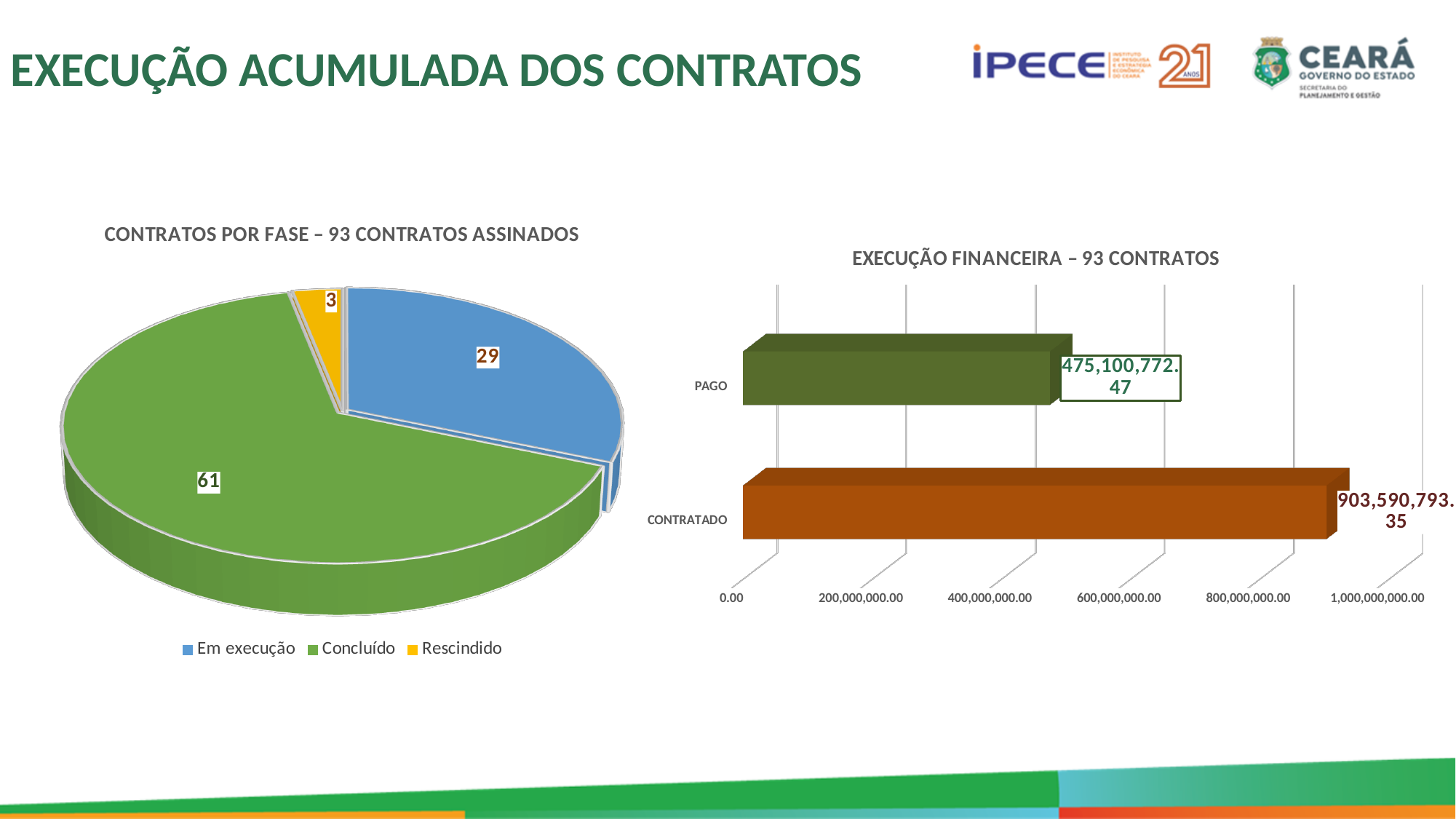
In the pie chart 'CONTRATOS POR FASE – 93 CONTRATOS ASSINADOS', how many contracts are 'Rescindido'? 3 In the chart 'EXECUÇÃO FINANCEIRA – 93 CONTRATOS', what is the value for PAGO? 475,100,772.47 In the pie chart 'CONTRATOS POR FASE – 93 CONTRATOS ASSINADOS', how many contracts are 'Concluído'? 61 In the pie chart 'CONTRATOS POR FASE – 93 CONTRATOS ASSINADOS', how many more contracts are 'Concluído' than 'Em execução'? 32 In the pie chart 'CONTRATOS POR FASE – 93 CONTRATOS ASSINADOS', how many contracts are 'Em execução'? 29 In the chart 'EXECUÇÃO FINANCEIRA – 93 CONTRATOS', what is the value for CONTRATADO? 903,590,793.35 What kind of chart is 'EXECUÇÃO FINANCEIRA – 93 CONTRATOS'? Bar chart In the pie chart 'CONTRATOS POR FASE – 93 CONTRATOS ASSINADOS', what colour is the 'Rescindido' slice? Yellow In the pie chart 'CONTRATOS POR FASE – 93 CONTRATOS ASSINADOS', how many categories does the legend list? 3 In the pie chart 'CONTRATOS POR FASE – 93 CONTRATOS ASSINADOS', which category has the largest slice? Concluído In the chart 'EXECUÇÃO FINANCEIRA – 93 CONTRATOS', what is the difference between CONTRATADO and PAGO? 428,490,020.88 In the pie chart 'CONTRATOS POR FASE – 93 CONTRATOS ASSINADOS', which category has the smallest slice? Rescindido